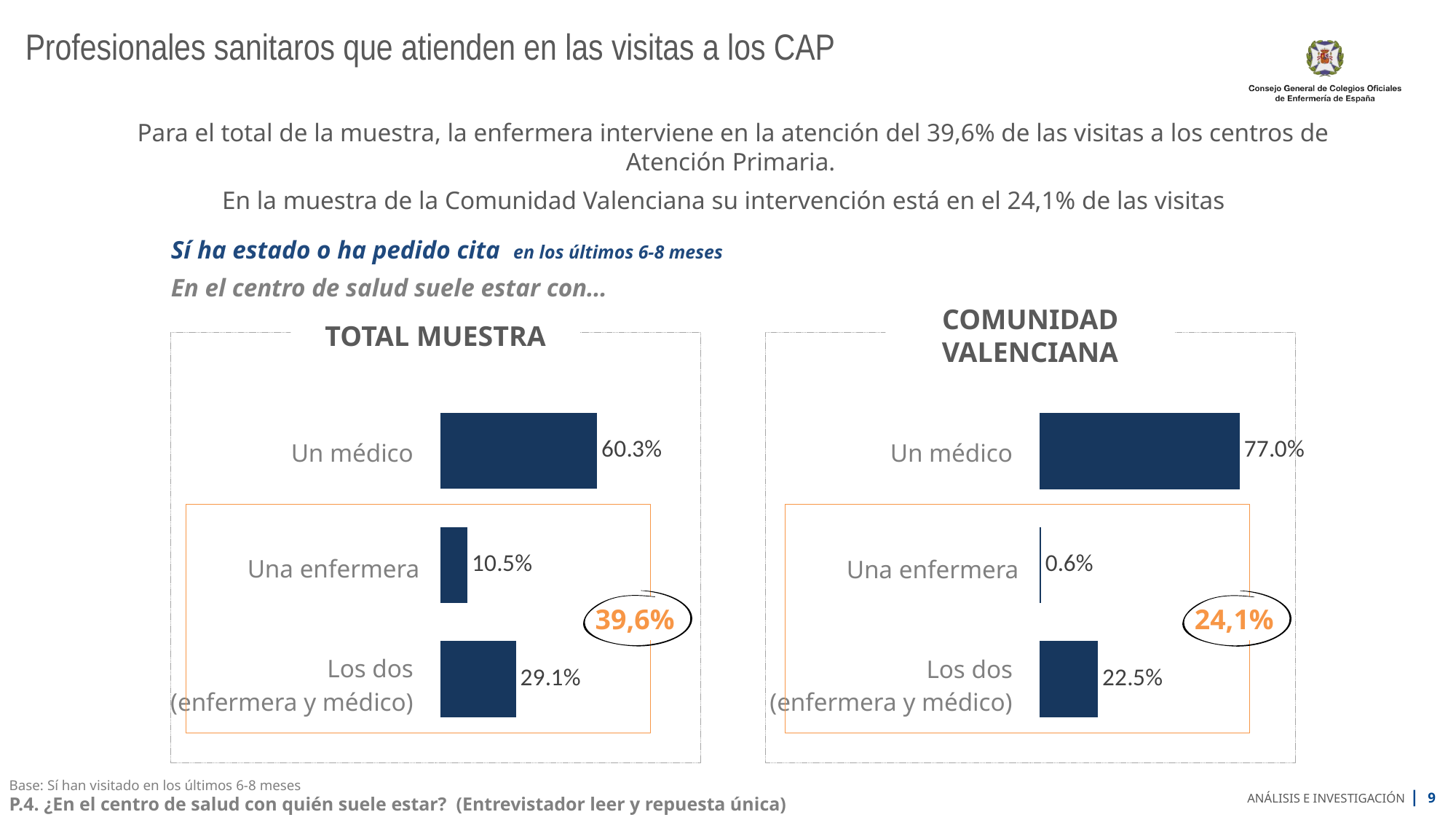
In the TOTAL MUESTRA chart, what is the difference between Un médico and Los dos (enfermera y médico)? 31.2% How many categories are shown in the TOTAL MUESTRA chart? 3 What kind of chart is the COMUNIDAD VALENCIANA chart? Bar chart What is the circled orange value shown on the TOTAL MUESTRA chart? 39,6% In the COMUNIDAD VALENCIANA chart, which category has the lowest value? Una enfermera Which chart has the larger value for Un médico, TOTAL MUESTRA or COMUNIDAD VALENCIANA? COMUNIDAD VALENCIANA In the TOTAL MUESTRA chart, which category has the highest value? Un médico In the TOTAL MUESTRA chart, what is the value for Un médico? 60.3% In the COMUNIDAD VALENCIANA chart, what is the value for Los dos (enfermera y médico)? 22.5% In the COMUNIDAD VALENCIANA chart, what is the difference between Un médico and Los dos (enfermera y médico)? 54.5% In the COMUNIDAD VALENCIANA chart, what is the value for Una enfermera? 0.6% In the TOTAL MUESTRA chart, what is the value for Una enfermera? 10.5%